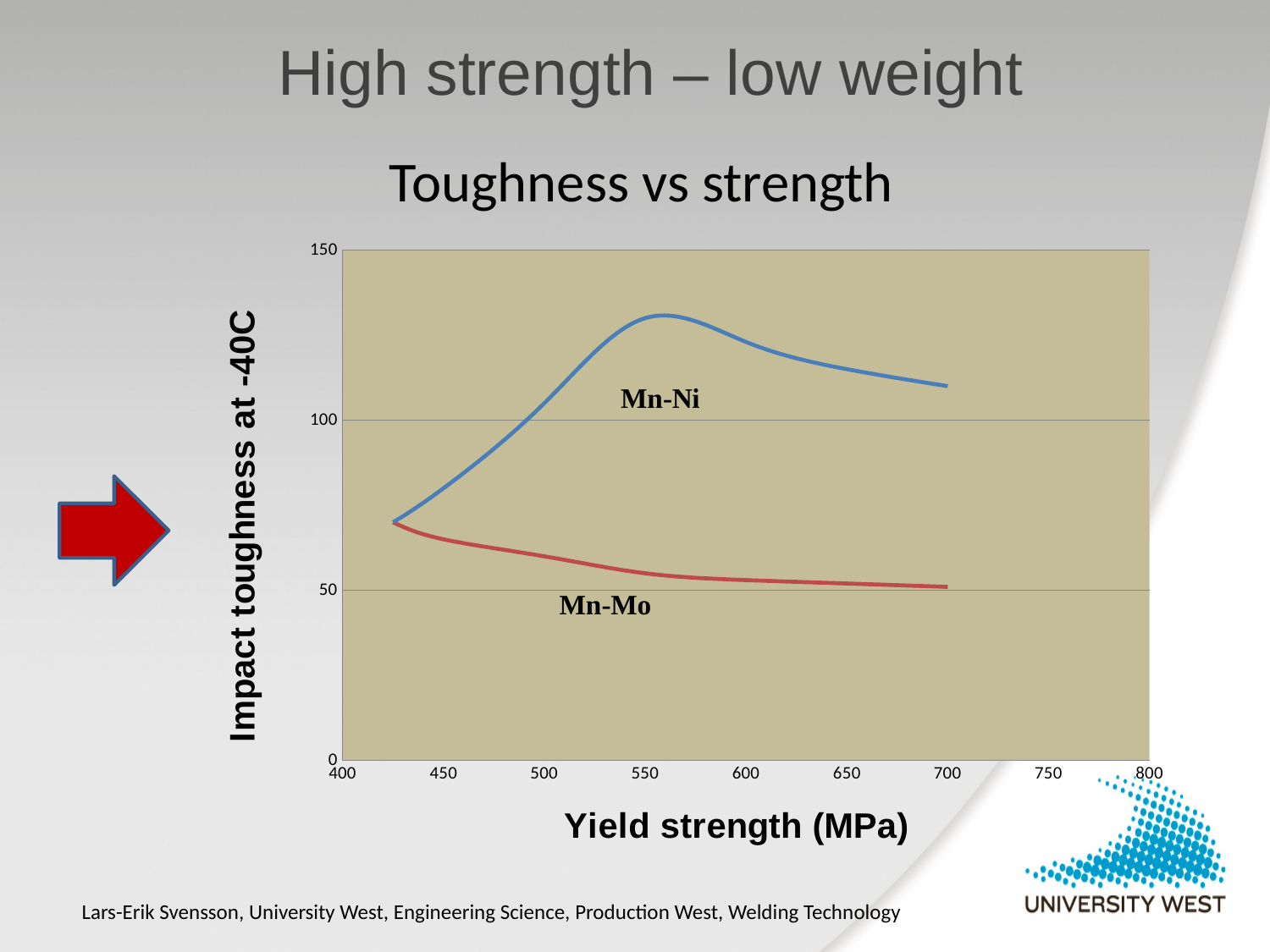
At a yield strength of 600 MPa, which curve has the higher impact toughness, Mn-Ni or Mn-Mo? Mn-Ni Is the value of the Mn-Ni curve at a yield strength of 700 MPa greater or less than 100? greater Is the value of the Mn-Ni curve at a yield strength of 550 MPa greater or less than 100? greater What is the label of the x axis? Yield strength (MPa) Is the value of the Mn-Mo curve at a yield strength of 700 MPa greater or less than 100? less Does the Mn-Ni curve rise or fall as yield strength increases from 450 to 550 MPa? rise What is the title of the chart? Toughness vs strength Does the Mn-Mo curve rise or fall as yield strength increases from 450 to 700 MPa? fall How many series are plotted on the chart? 2 What kind of chart is shown on the slide? line chart Which series reaches the highest impact toughness on the chart? Mn-Ni